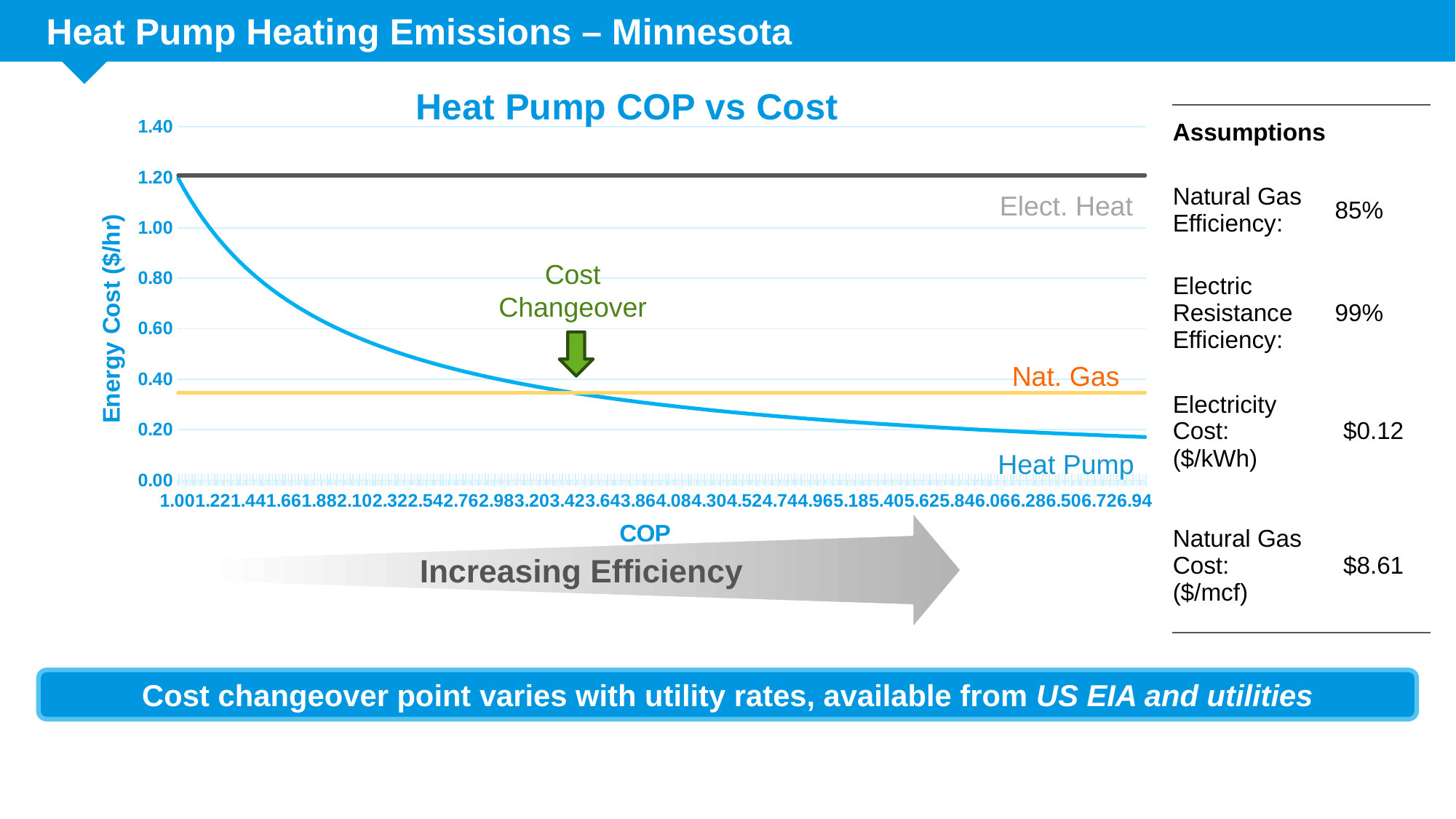
What is the title of the chart? Heat Pump COP vs Cost What is the label of the vertical axis of the chart? Energy Cost ($/hr) How many series are plotted on the chart? 3 Is the value of the Nat. Gas line greater or less than 0.40? less Which series has the highest energy cost across the chart? Elect. Heat Which series has the lowest energy cost at a COP of 6.94? Heat Pump Is the Heat Pump value at a COP of 1.00 greater or less than 1.00? greater At a COP of 6.00, which is larger: the Nat. Gas cost or the Heat Pump cost? Nat. Gas At a COP of 2.00, which is larger: the Heat Pump cost or the Nat. Gas cost? Heat Pump What kind of chart is shown on the slide? line chart Does the Heat Pump line rise or fall as COP increases along the x axis? fall